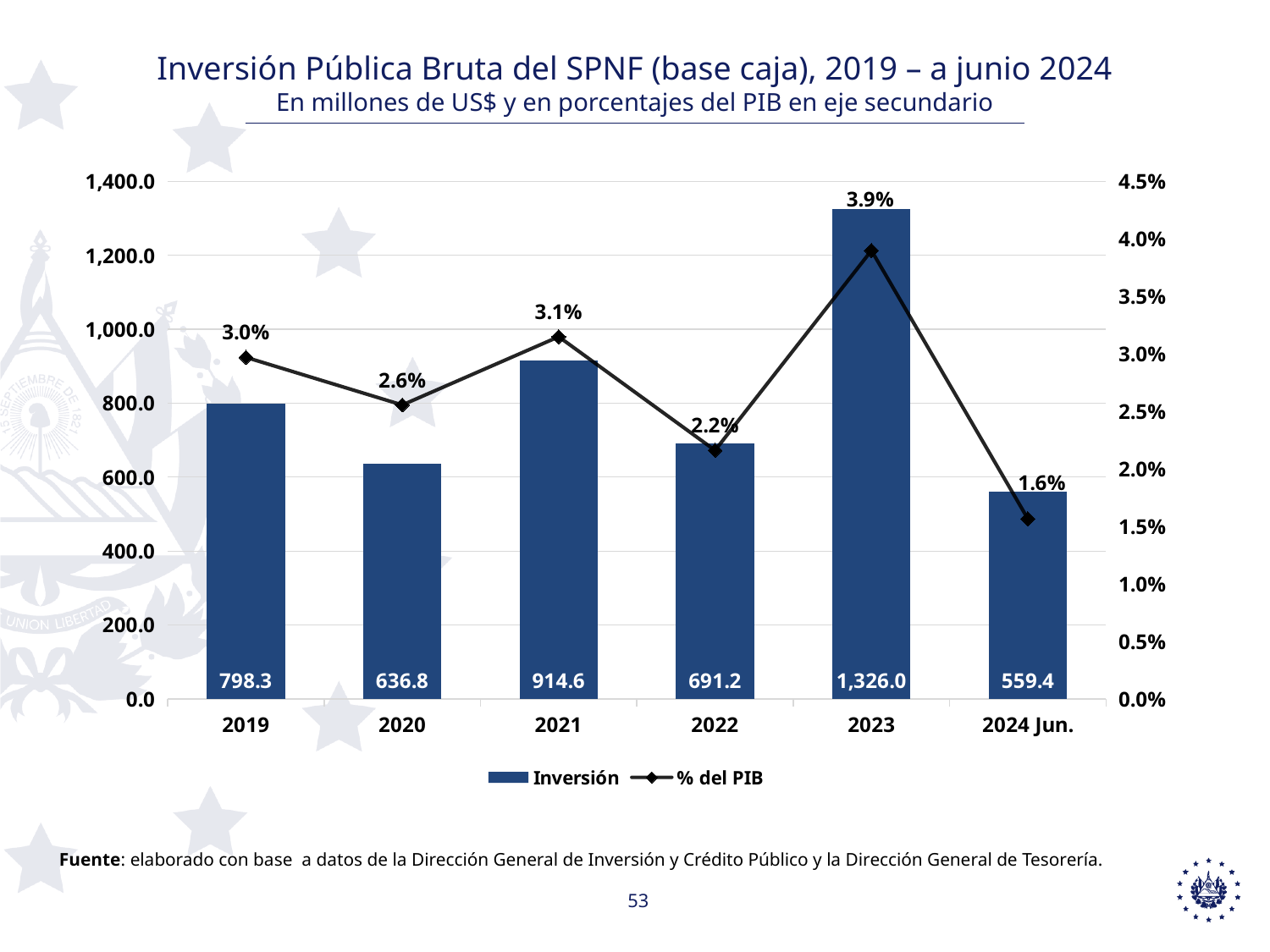
What kind of chart is used to show the Inversión series? bar chart Which is larger, the Inversión value for 2019 or for 2022? 2019 What is the Inversión value for 2023? 1,326.0 Does the % del PIB value rise or fall from 2023 to 2024 Jun.? fall How many categories are shown on the x axis? 6 Which category has the lowest % del PIB value? 2024 Jun. Which year has the highest Inversión value? 2023 How many series does the legend list? 2 What is the % del PIB value for 2021? 3.1% What is the difference between the Inversión values for 2021 and 2020? 277.8 What is the Inversión value for 2024 Jun.? 559.4 What is the title of the chart? Inversión Pública Bruta del SPNF (base caja), 2019 – a junio 2024